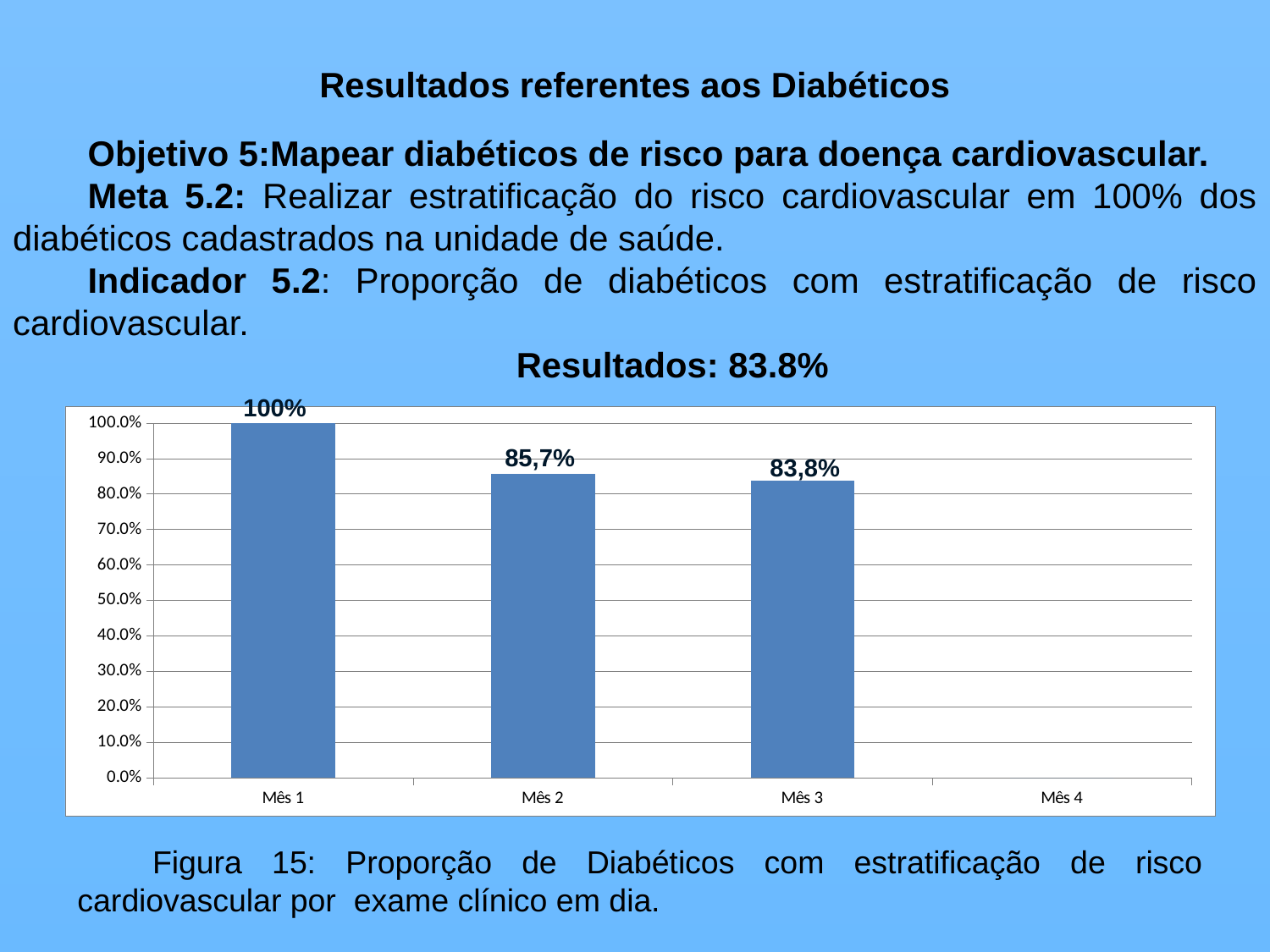
What is the difference between the values for Mês 2 and Mês 3? 1,9 percentage points Among the months with a plotted bar, which has the lowest value? Mês 3 What is the difference between the values for Mês 1 and Mês 2? 14,3 percentage points Do the values rise or fall from Mês 1 to Mês 3? fall Which month has the highest value? Mês 1 How many categories are shown on the x axis? 4 Which is larger, the value for Mês 2 or the value for Mês 3? Mês 2 What kind of chart is shown on the slide? bar chart What is the value for Mês 2? 85,7% Is the value for Mês 3 greater or less than 90.0%? less What is the value for Mês 3? 83,8% What is the value for Mês 1? 100%